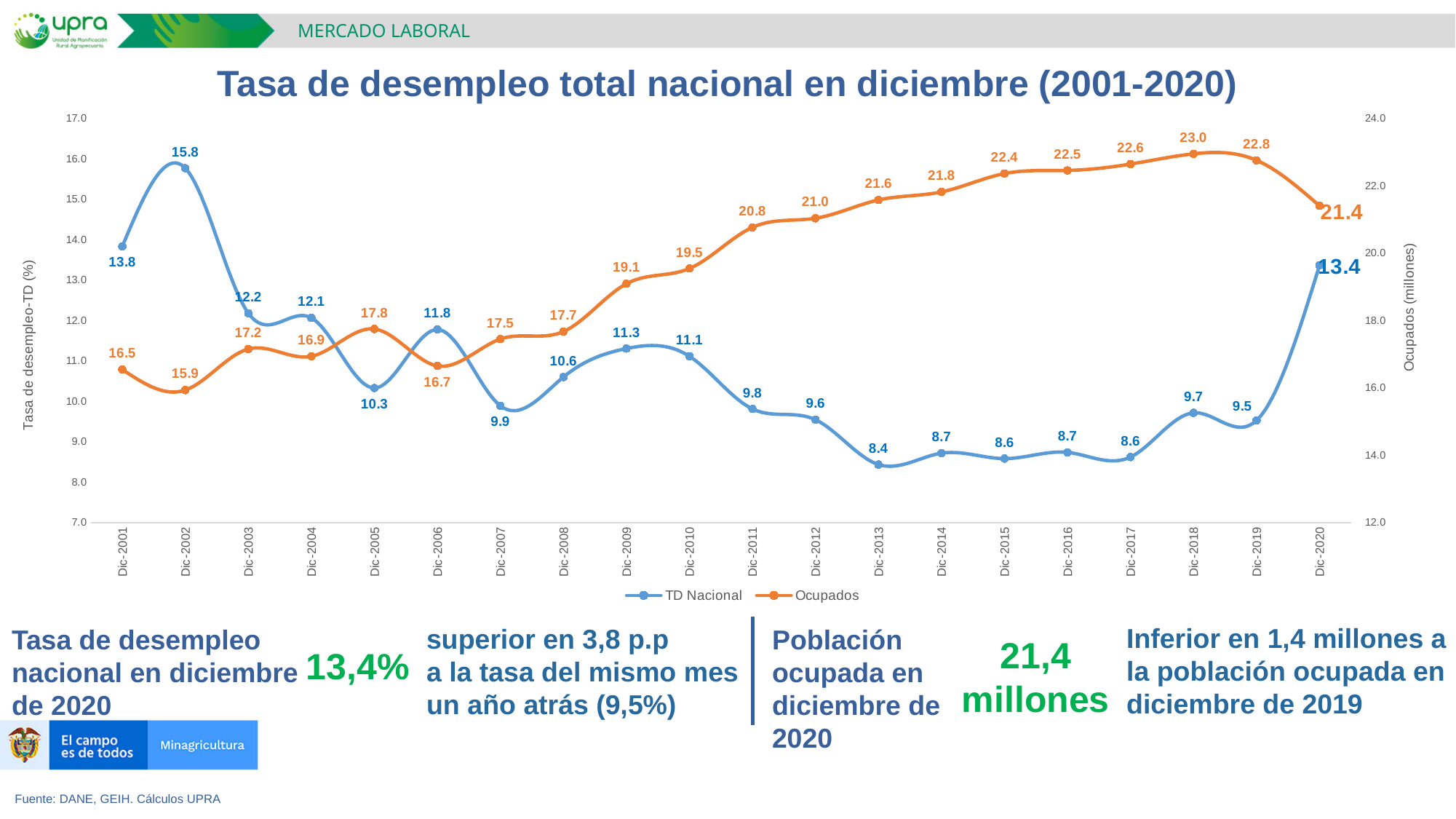
What is the difference between the Ocupados values for Dic-2019 and Dic-2020? 1.4 How many years (data points) are plotted on the x axis? 20 What is the Ocupados value for Dic-2020? 21.4 In which year does the Ocupados series have its lowest value? Dic-2002 What is the TD Nacional value for Dic-2013? 8.4 What kind of chart is shown on the slide? Line chart Which is larger, the TD Nacional value for Dic-2020 or for Dic-2019? Dic-2020 Does the Ocupados series rise or fall from Dic-2009 to Dic-2018? Rise In which year does the Ocupados series reach its highest value? Dic-2018 How many series does the legend list? 2 In which year does the TD Nacional series reach its highest value? Dic-2002 What is the TD Nacional value for Dic-2002? 15.8